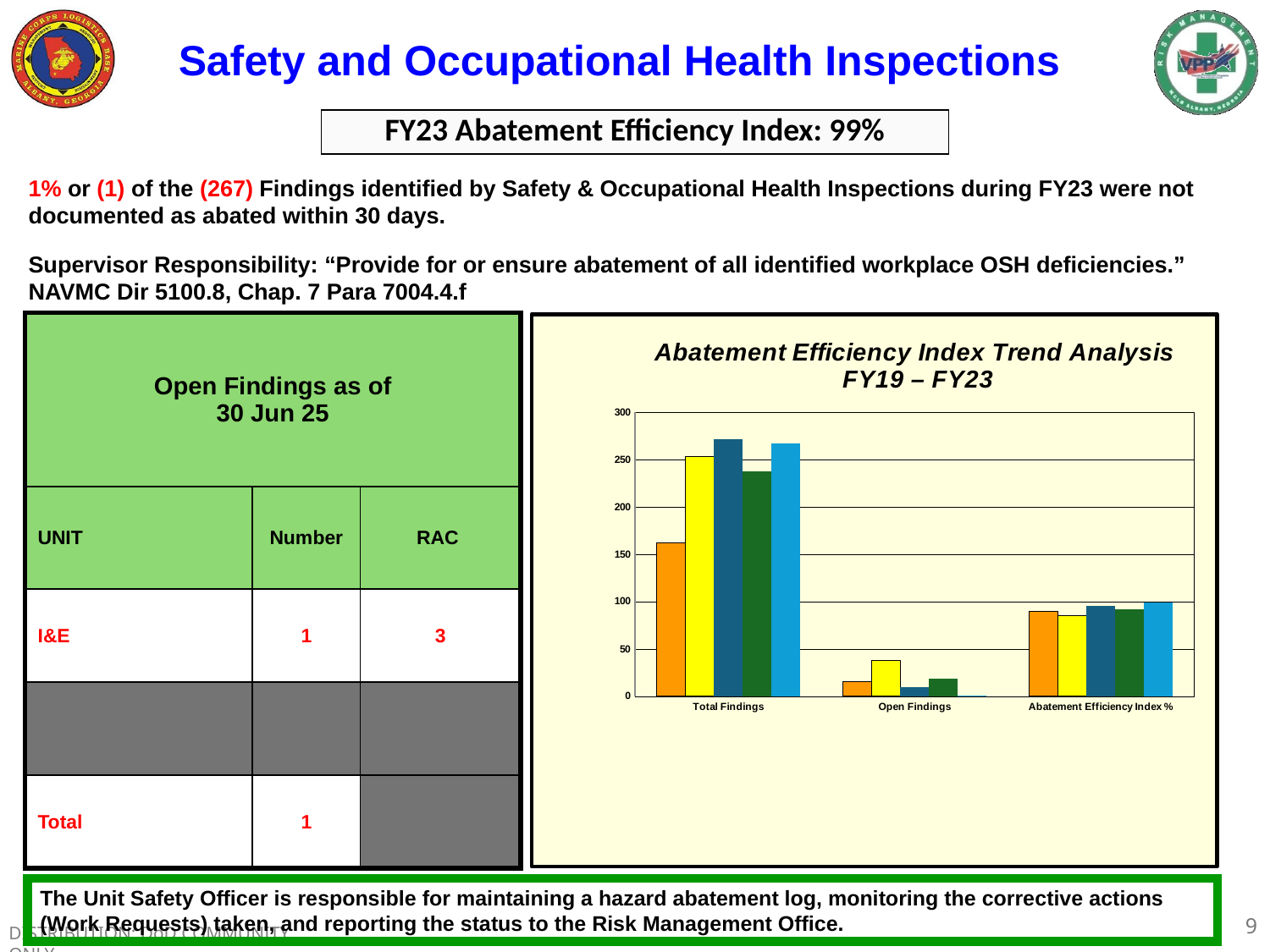
How many categories are shown along the x axis of the Abatement Efficiency Index Trend Analysis chart? 3 In the Abatement Efficiency Index Trend Analysis chart, is the tallest bar in the Open Findings group greater or less than 50? less In the Abatement Efficiency Index Trend Analysis chart, which category contains the tallest bar? Total Findings In the Abatement Efficiency Index Trend Analysis chart, which is larger: the first (orange) bar for Total Findings or the first (orange) bar for Abatement Efficiency Index %? Total Findings In the Abatement Efficiency Index Trend Analysis chart, which category has the shortest bars? Open Findings In the Abatement Efficiency Index Trend Analysis chart, is the tallest bar in the Total Findings group greater or less than 250? greater In the Abatement Efficiency Index Trend Analysis chart, is the first (orange) bar in the Total Findings group greater or less than 150? greater What kind of chart is shown under the title "Abatement Efficiency Index Trend Analysis FY19 – FY23"? bar chart What is the highest value shown on the y axis of the Abatement Efficiency Index Trend Analysis chart? 300 What is the title of the chart on the right side of the slide? Abatement Efficiency Index Trend Analysis FY19 – FY23